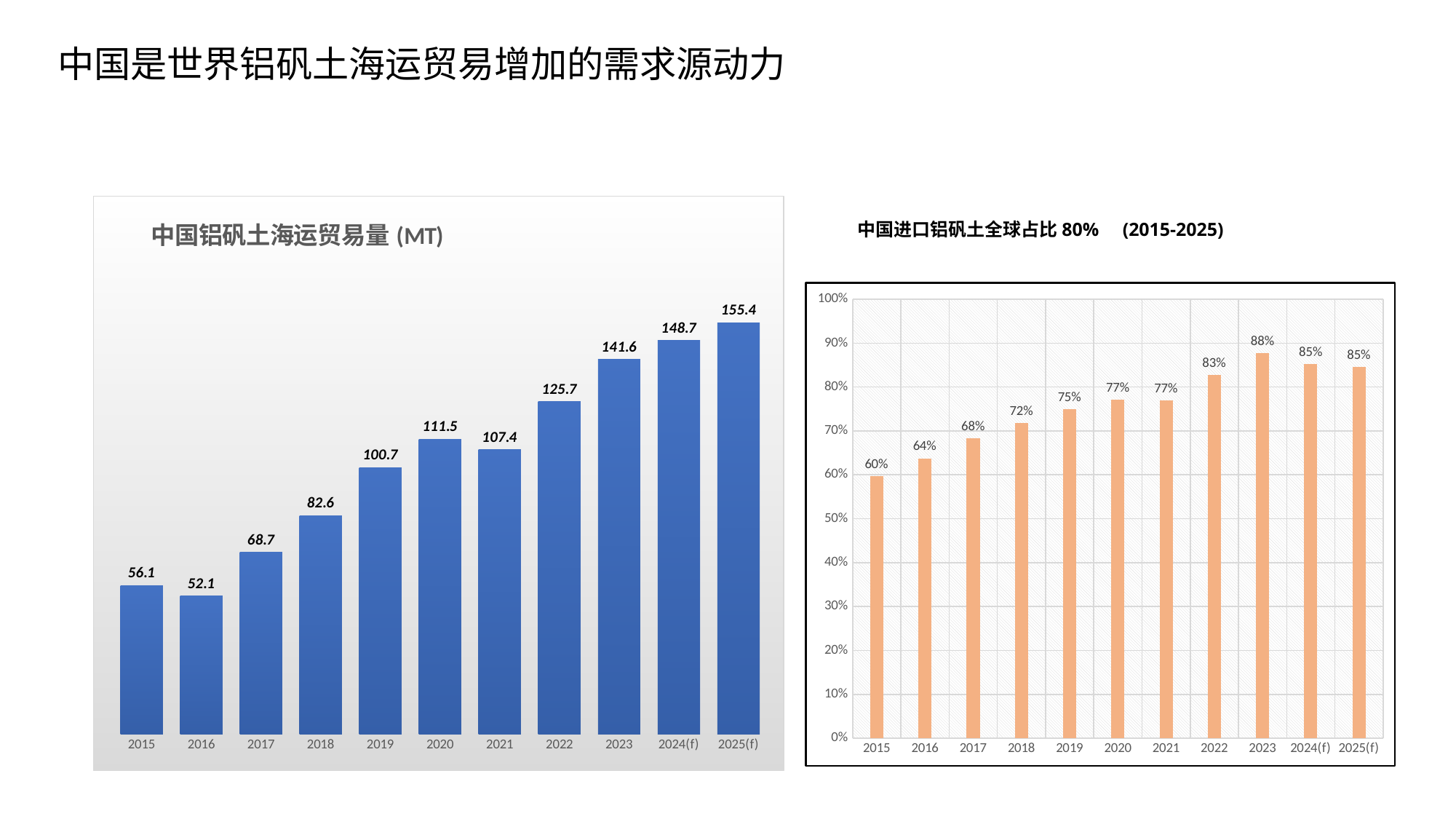
In the left chart (中国铝矾土海运贸易量 (MT)), what is the difference between the values for 2022 and 2021? 18.3 In the left chart (中国铝矾土海运贸易量 (MT)), which year has the highest value? 2025(f) In the right chart (中国进口铝矾土全球占比 80% (2015-2025)), do the values generally rise or fall from 2015 to 2023? rise What kind of chart is the left chart (中国铝矾土海运贸易量 (MT))? bar chart In the left chart (中国铝矾土海运贸易量 (MT)), which is larger, the value for 2020 or the value for 2021? 2020 In the left chart (中国铝矾土海运贸易量 (MT)), which year has the lowest value? 2016 In the right chart (中国进口铝矾土全球占比 80% (2015-2025)), what is the difference between the values for 2023 and 2015? 28% In the right chart (中国进口铝矾土全球占比 80% (2015-2025)), what is the value for 2018? 72% In the left chart (中国铝矾土海运贸易量 (MT)), what is the value for 2019? 100.7 In the right chart (中国进口铝矾土全球占比 80% (2015-2025)), which year has the highest value? 2023 What colour are the bars in the right chart (中国进口铝矾土全球占比 80% (2015-2025))? orange In the left chart (中国铝矾土海运贸易量 (MT)), how many years are shown on the x axis? 11